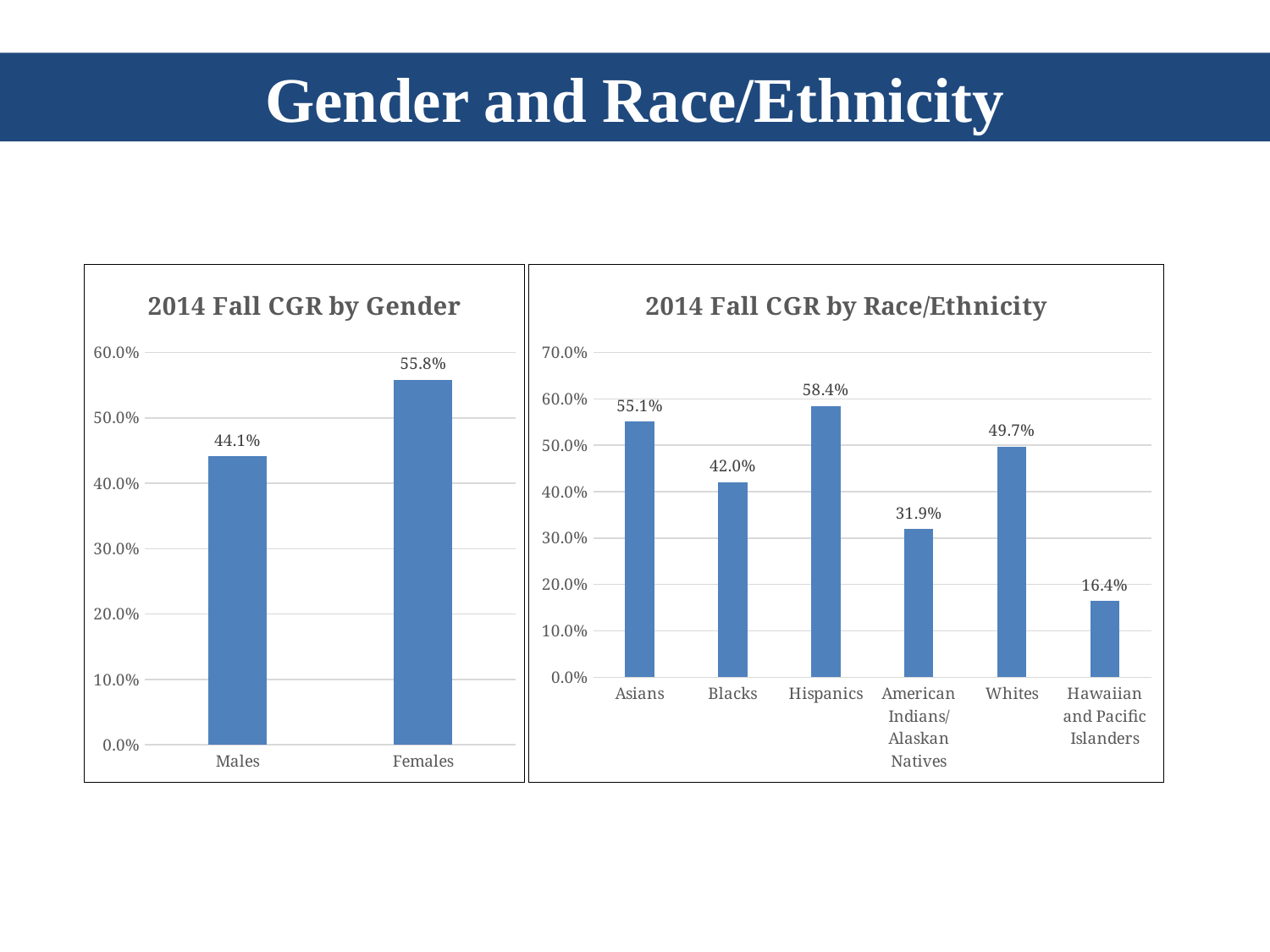
In the '2014 Fall CGR by Race/Ethnicity' chart, which category has the highest value? Hispanics In the '2014 Fall CGR by Race/Ethnicity' chart, is the value for Whites greater or less than 40.0%? greater In the '2014 Fall CGR by Gender' chart, what is the value for Males? 44.1% In the '2014 Fall CGR by Race/Ethnicity' chart, what is the difference between the values for Asians and Blacks? 13.1% What kind of chart is the '2014 Fall CGR by Gender' chart? Bar chart In the '2014 Fall CGR by Race/Ethnicity' chart, what is the value for Hawaiian and Pacific Islanders? 16.4% In the '2014 Fall CGR by Race/Ethnicity' chart, how many categories are shown? 6 In the '2014 Fall CGR by Gender' chart, what is the value for Females? 55.8% In the '2014 Fall CGR by Gender' chart, which category has the higher value, Males or Females? Females In the '2014 Fall CGR by Race/Ethnicity' chart, which category has the lowest value? Hawaiian and Pacific Islanders In the '2014 Fall CGR by Race/Ethnicity' chart, what is the value for Hispanics? 58.4% In the '2014 Fall CGR by Gender' chart, what is the difference between the Females and Males values? 11.7%